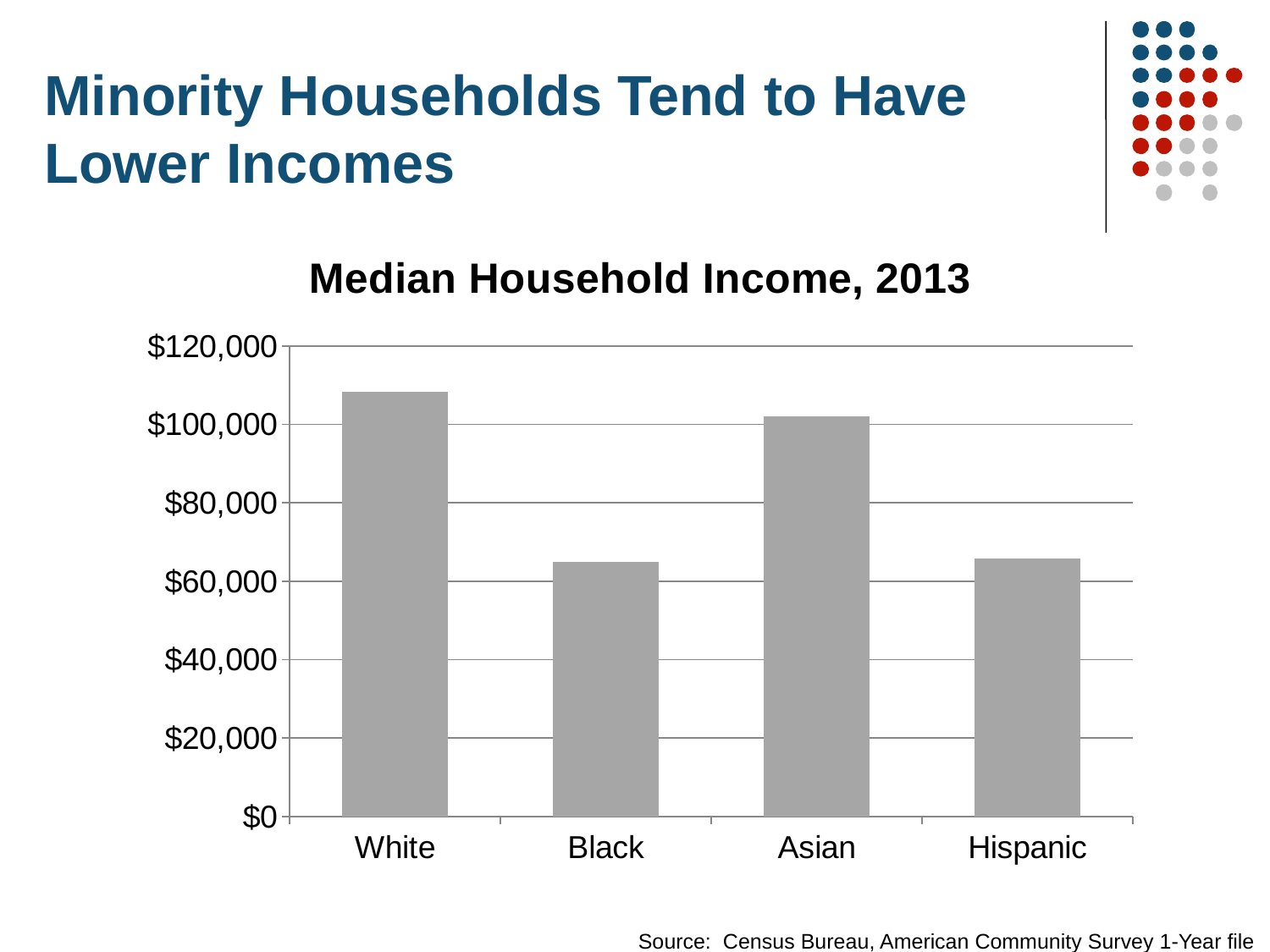
Is the value for Asian greater or less than $80,000? greater Is the value for Black greater or less than $60,000? greater How many categories are shown on the x axis of the chart? 4 Is the value for Black greater or less than $80,000? less What is the source cited for the chart's data? Census Bureau, American Community Survey 1-Year file Which is larger, the value for Asian or the value for Hispanic? Asian Which is larger, the value for White or the value for Black? White What kind of chart is shown on the slide? bar chart Which category has the highest median household income in the chart? White What is the title of the chart? Median Household Income, 2013